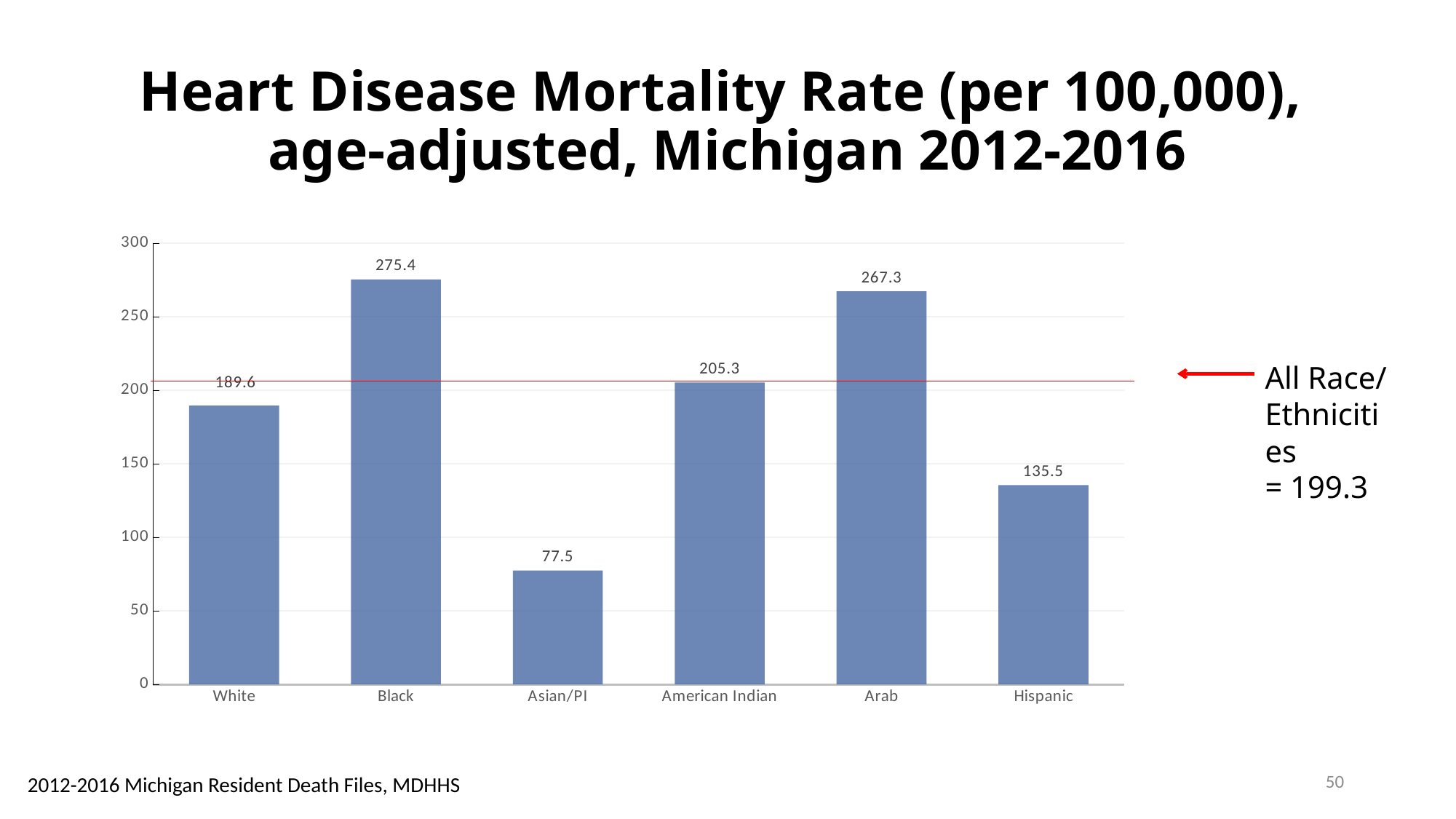
Which race/ethnicity group has the lowest heart disease mortality rate? Asian/PI What kind of chart is shown on the slide? bar chart Is the heart disease mortality rate for Hispanic residents greater or less than 150? less What is the heart disease mortality rate for Asian/PI residents? 77.5 What is the difference between the heart disease mortality rates for American Indian and White residents? 15.7 Which race/ethnicity group has the highest heart disease mortality rate? Black What is the heart disease mortality rate for Black residents? 275.4 Which group has a higher heart disease mortality rate, White or American Indian? American Indian What is the heart disease mortality rate for Hispanic residents? 135.5 What is the difference between the heart disease mortality rates for Black and Arab residents? 8.1 How many race/ethnicity groups are shown on the chart? 6 What value does the horizontal reference line labelled 'All Race/Ethnicities' represent? 199.3